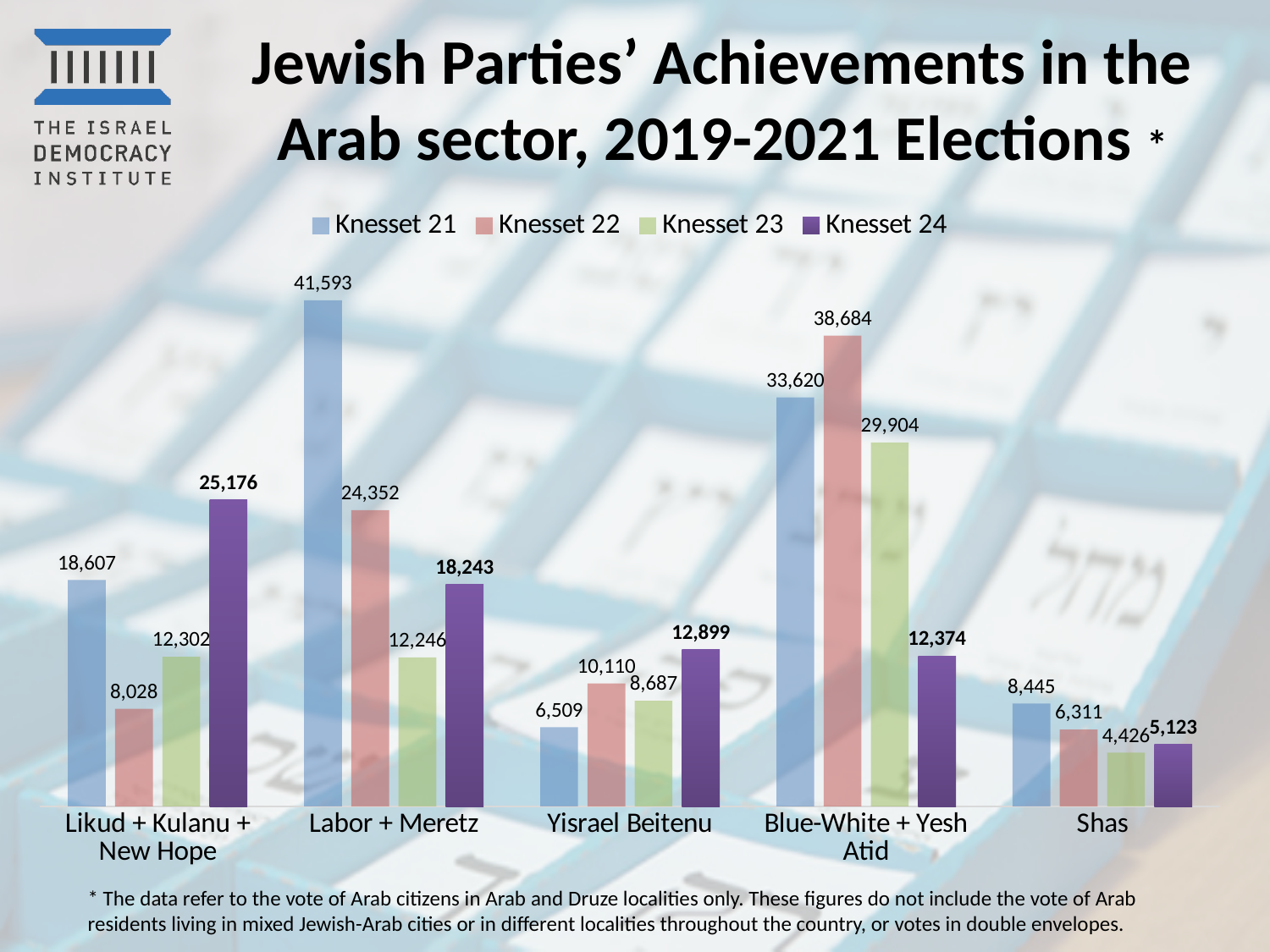
What is the Knesset 24 value for Likud + Kulanu + New Hope? 25,176 Do the values for Blue-White + Yesh Atid rise or fall from Knesset 22 to Knesset 24? Fall What is the Knesset 21 value for Labor + Meretz? 41,593 How many party groups are shown on the x axis? 5 What is the difference between the Knesset 22 and Knesset 21 values for Blue-White + Yesh Atid? 5,064 Which party group has the highest Knesset 24 value? Likud + Kulanu + New Hope How many series does the legend list? 4 What is the Knesset 23 value for Shas? 4,426 Which party group has the lowest Knesset 21 value? Yisrael Beitenu What is the Knesset 22 value for Blue-White + Yesh Atid? 38,684 What kind of chart is shown on the slide? Bar chart Which is larger for Yisrael Beitenu: the Knesset 22 value or the Knesset 23 value? Knesset 22